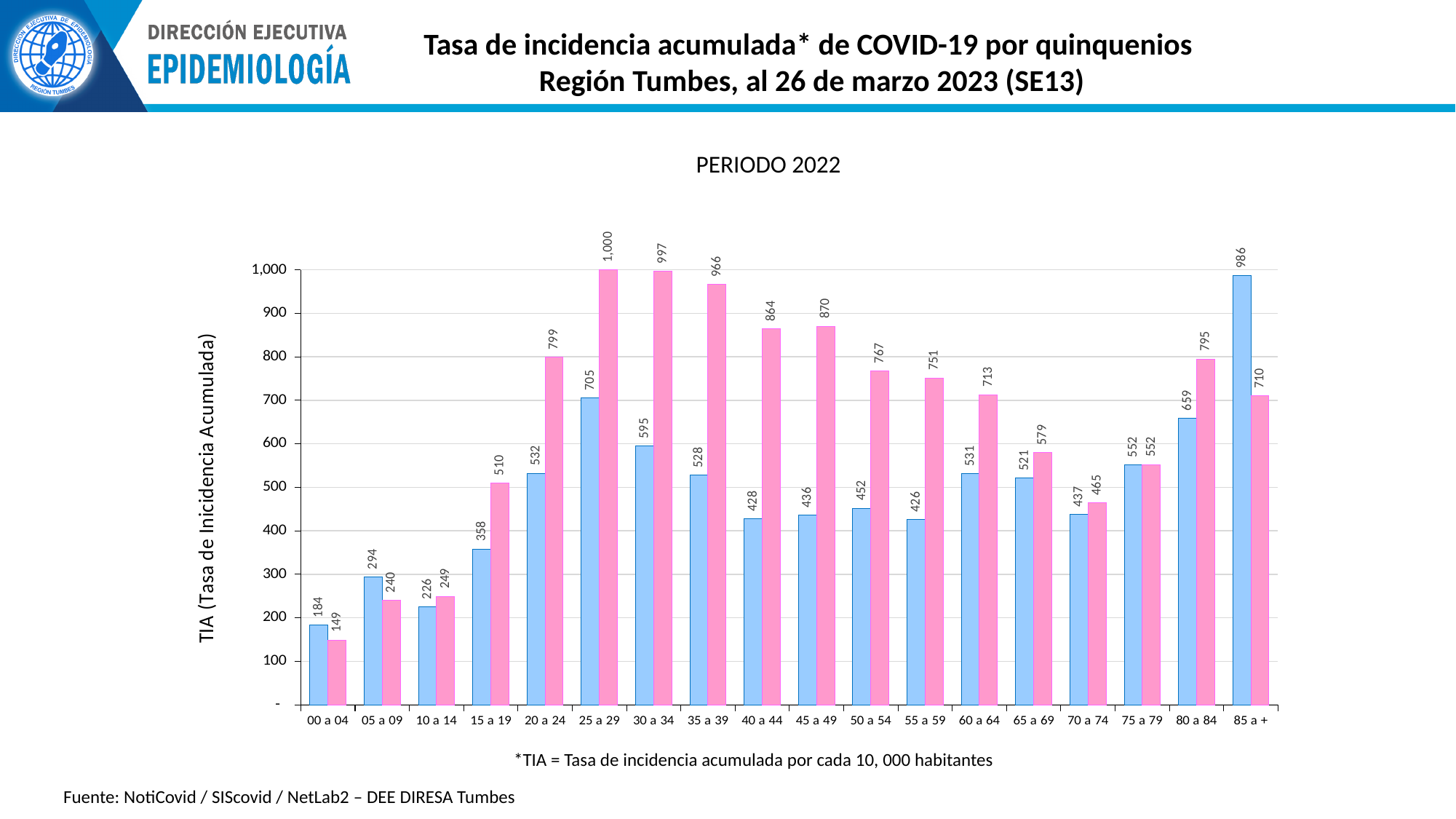
What is the value of the pink bar for the 85 a + age group? 710 What is the difference between the pink and blue bars for the 25 a 29 age group? 295 What is the value of the blue bar for the 25 a 29 age group? 705 What is the title shown above the chart? PERIODO 2022 What kind of chart is shown on the slide? bar chart Which age group has the lowest pink bar? 00 a 04 Which is larger for the 05 a 09 age group, the blue bar or the pink bar? the blue bar How many age groups are shown on the x axis? 18 Which age group has the highest pink bar? 25 a 29 What is the difference between the blue and pink bars for the 85 a + age group? 276 What is the value of the pink bar for the 40 a 44 age group? 864 Which age group has the highest blue bar? 85 a +